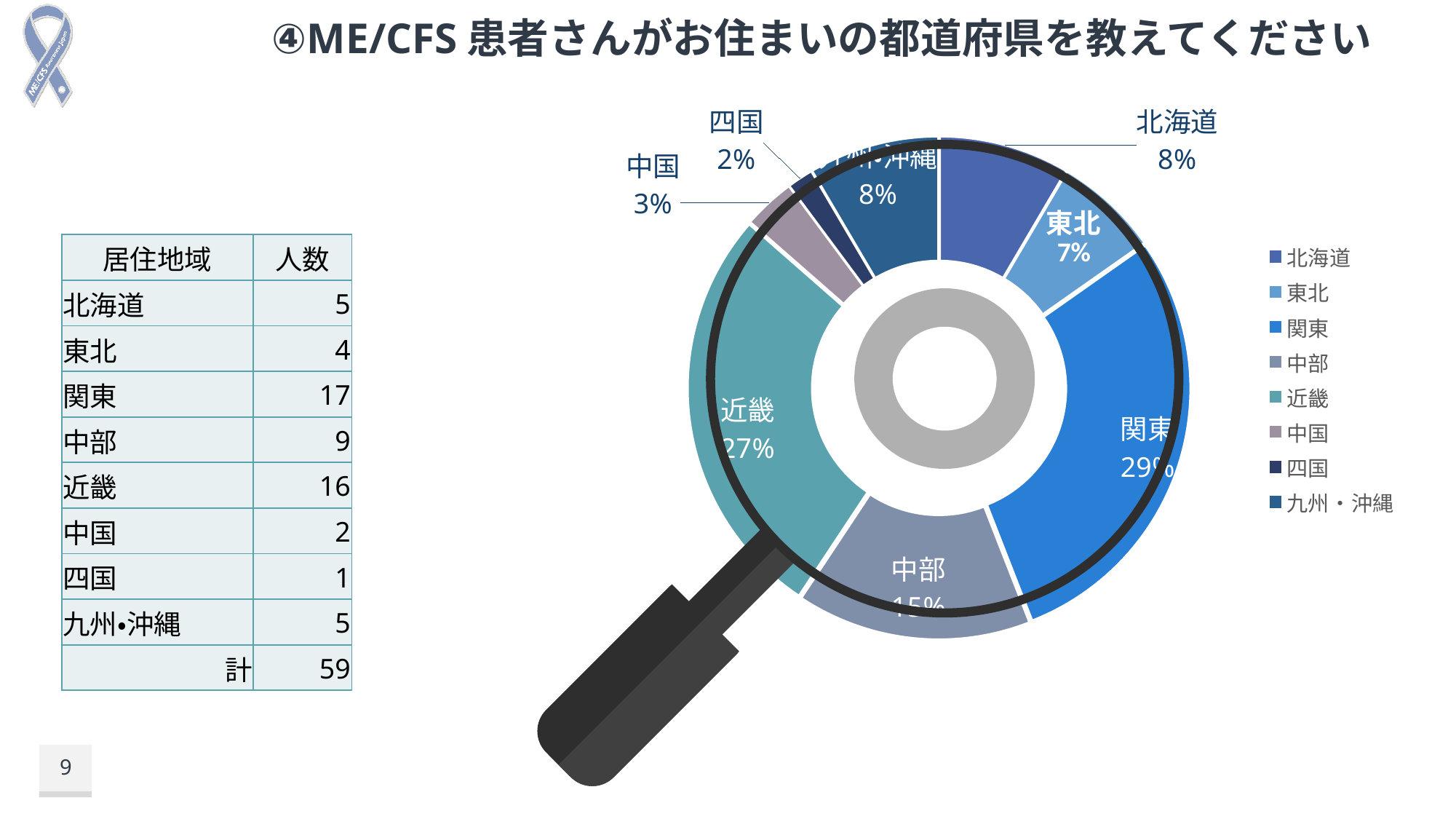
What percentage share does 北海道 have in the chart? 8% What type of chart is shown on the slide? Doughnut (pie) chart What percentage share does 近畿 have in the chart? 27% What percentage share does 四国 have in the chart? 2% Which region has the smallest share in the chart? 四国 What percentage share does 東北 have in the chart? 7% Which legend entry is listed last in the chart legend? 九州・沖縄 How many regions are listed in the chart legend? 8 What percentage share does 中国 have in the chart? 3% Which has a larger share, 近畿 or 中部? 近畿 Which region has the largest share in the chart? 関東 What is the difference in percentage points between 近畿 and 中部? 12